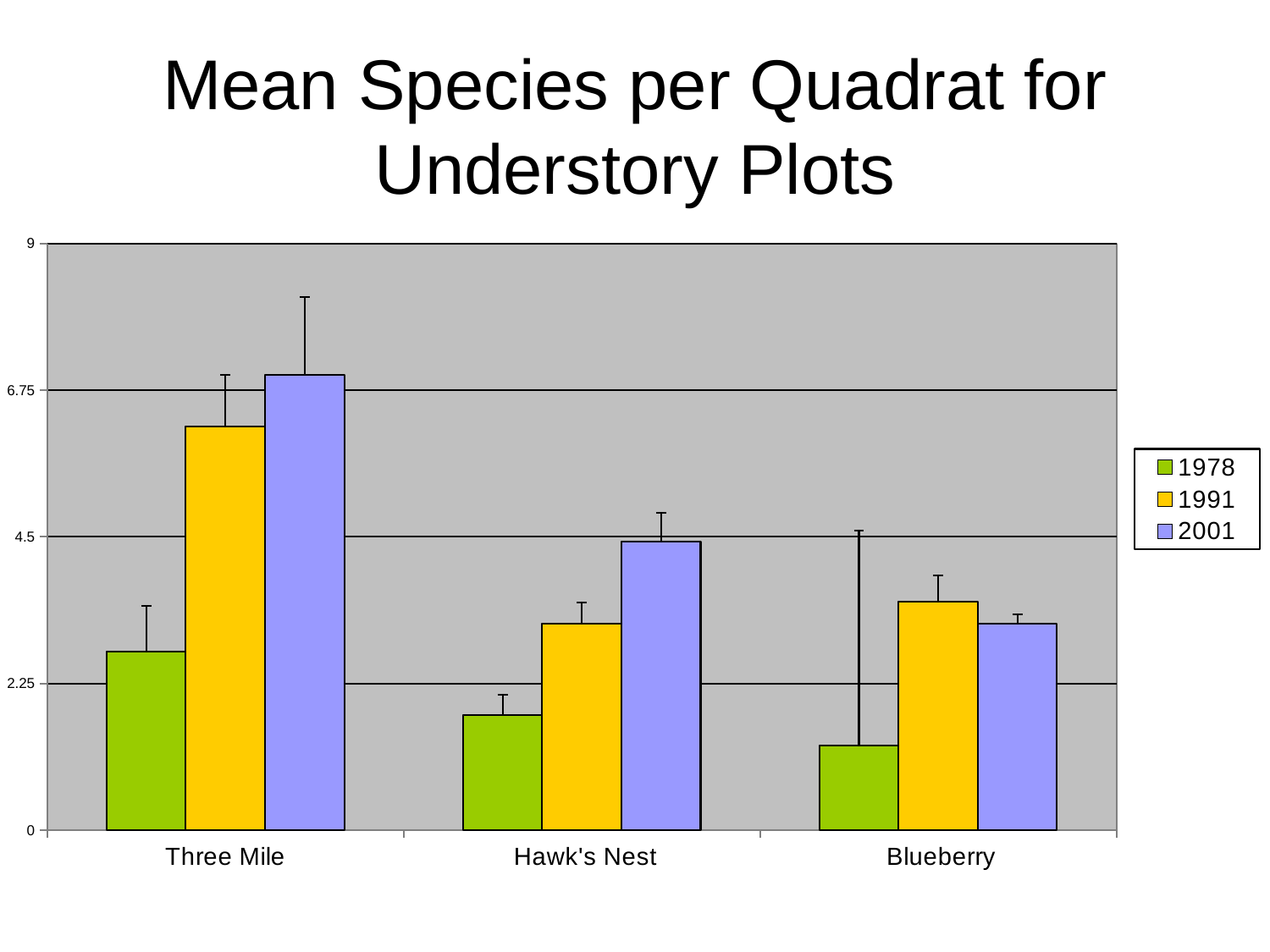
Which plot has the highest bar for 2001? Three Mile How many series does the legend list? 3 What kind of chart is shown on the slide? bar chart For Three Mile, do the values rise or fall from 1978 to 2001? rise Which plot has the lowest bar for 1978? Blueberry Which is larger, the 1991 value for Three Mile or the 1991 value for Hawk's Nest? Three Mile Which years are listed in the legend? 1978, 1991, 2001 How many plot categories are shown on the x axis? 3 What is the title of the chart? Mean Species per Quadrat for Understory Plots Is the value for Three Mile in 2001 greater or less than 6.75? greater Is the value for Hawk's Nest in 1978 greater or less than 2.25? less Is the value for Blueberry in 1991 greater or less than 4.5? less